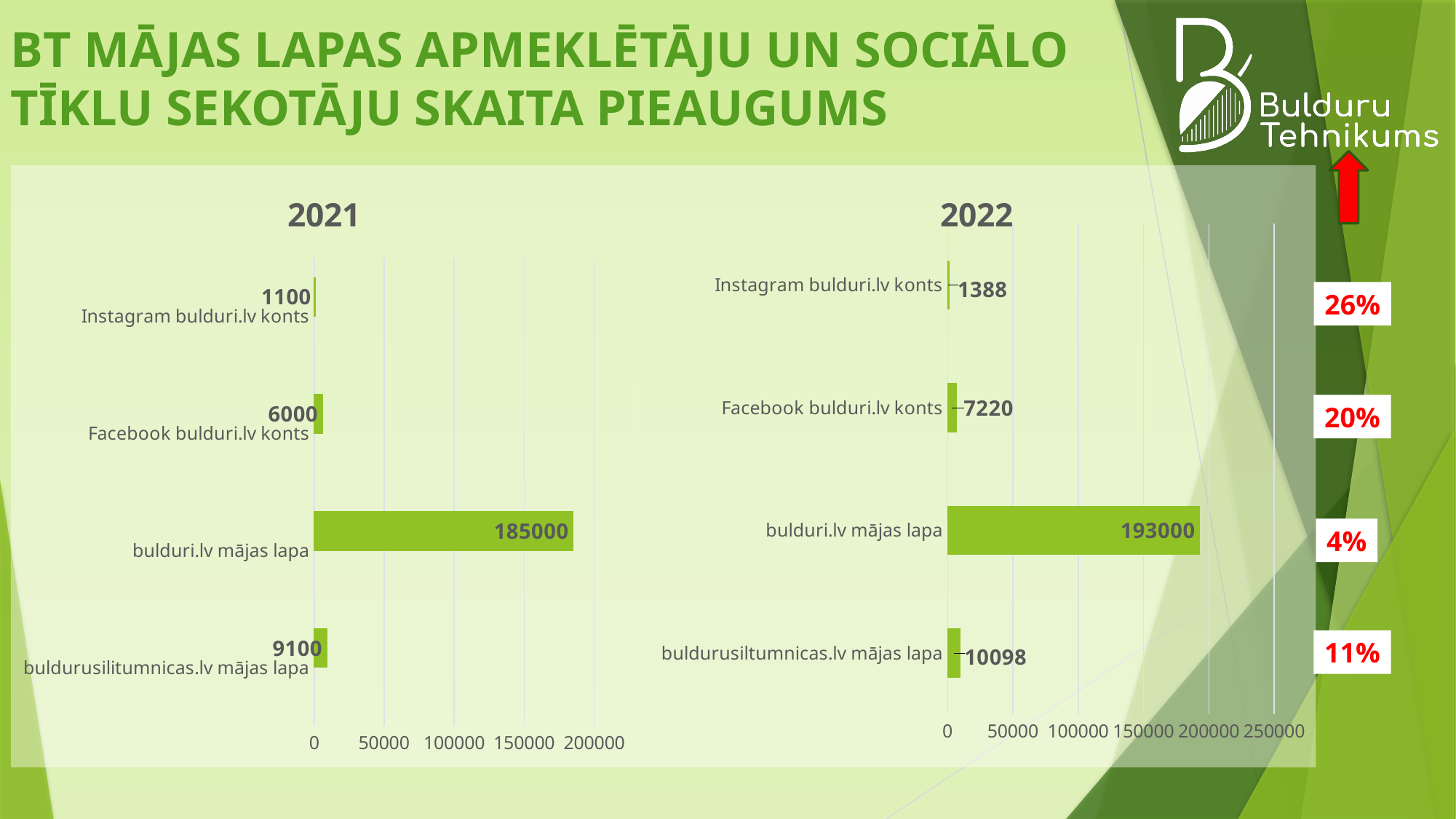
In the 2022 chart, which is larger: the value for Facebook bulduri.lv konts or the value for buldurusiltumnicas.lv mājas lapa? buldurusiltumnicas.lv mājas lapa In the 2022 chart, what is the value for Facebook bulduri.lv konts? 7220 In the 2022 chart, what is the value for buldurusiltumnicas.lv mājas lapa? 10098 In the 2021 chart, what is the value for Instagram bulduri.lv konts? 1100 In the 2021 chart, which category has the lowest value? Instagram bulduri.lv konts How many categories does the 2021 chart show? 4 In the 2022 chart, is the value for bulduri.lv mājas lapa greater or less than 150000? greater In the 2021 chart, what is the difference between the Facebook bulduri.lv konts value and the Instagram bulduri.lv konts value? 4900 In the 2021 chart, what is the value for bulduri.lv mājas lapa? 185000 What is the difference between the bulduri.lv mājas lapa value in the 2022 chart and in the 2021 chart? 8000 In the 2022 chart, which category has the highest value? bulduri.lv mājas lapa What kind of chart is the 2022 chart? bar chart